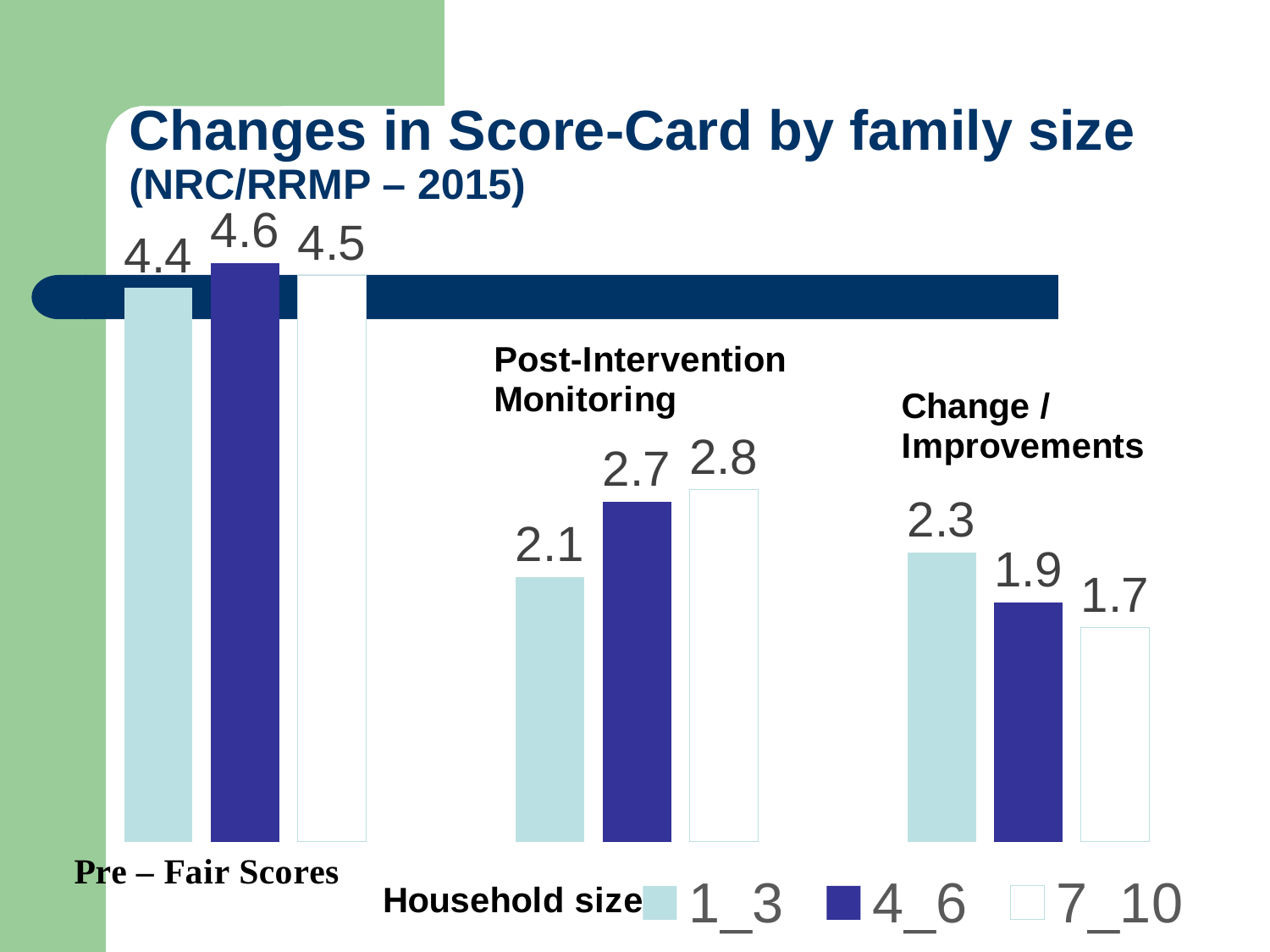
What is the difference between the Pre – Fair Score and the Post-Intervention Monitoring value for household size 1_3? 2.3 Which is larger for household size 7_10: the Post-Intervention Monitoring value or the Change / Improvements value? Post-Intervention Monitoring What kind of chart is shown on the slide? Bar chart What is the Post-Intervention Monitoring value for household size 1_3? 2.1 What is the Pre – Fair Score for household size 4_6? 4.6 What is the Change / Improvements value for household size 7_10? 1.7 Which household size has the highest Change / Improvements value? 1_3 Which household size has the lowest Post-Intervention Monitoring value? 1_3 How many category groups are shown on the chart? 3 How many household size series does the legend list? 3 Which household size has the highest Pre – Fair Score? 4_6 Which household size is represented by the dark blue bars? 4_6